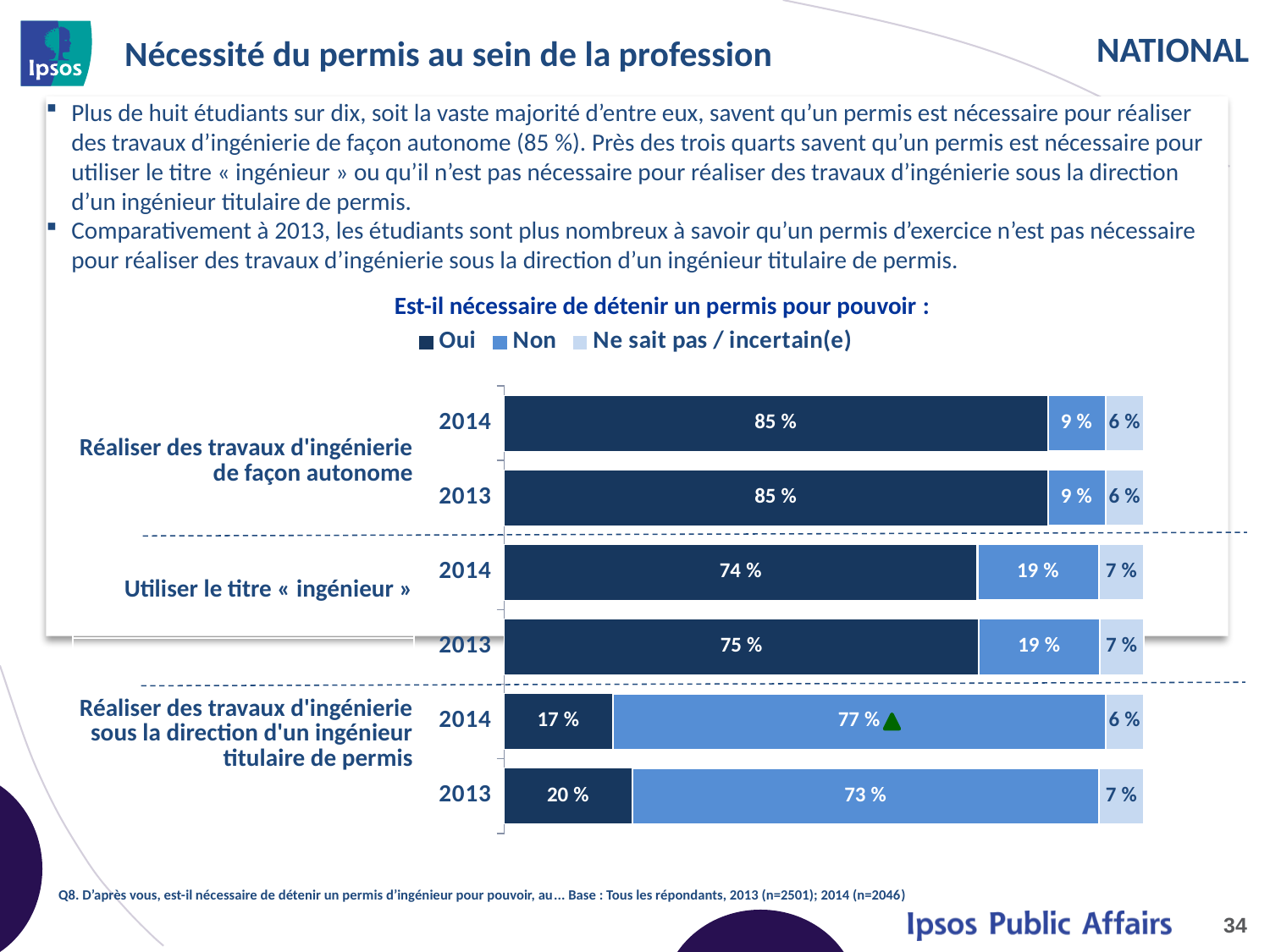
What is the 'Oui' value for 'Réaliser des travaux d'ingénierie sous la direction d'un ingénieur titulaire de permis' in 2013? 20 % What is the title of the chart? Est-il nécessaire de détenir un permis pour pouvoir : What is the 'Non' value for 'Réaliser des travaux d'ingénierie sous la direction d'un ingénieur titulaire de permis' in 2014? 77 % What is the difference between the 'Non' values for 'Réaliser des travaux d'ingénierie sous la direction d'un ingénieur titulaire de permis' in 2014 and 2013? 4 % Which item has the lowest 'Oui' value in 2014? Réaliser des travaux d'ingénierie sous la direction d'un ingénieur titulaire de permis Which item has the highest 'Oui' value in 2014? Réaliser des travaux d'ingénierie de façon autonome For 'Utiliser le titre « ingénieur »', is the 'Oui' value larger in 2013 or 2014? 2013 What is the 'Non' value for 'Utiliser le titre « ingénieur »' in 2014? 19 % How many series does the chart legend list? 3 What is the 'Oui' value for 'Réaliser des travaux d'ingénierie de façon autonome' in 2014? 85 % What kind of chart is shown on the slide? Stacked bar chart What is the 'Ne sait pas / incertain(e)' value for 'Utiliser le titre « ingénieur »' in 2013? 7 %